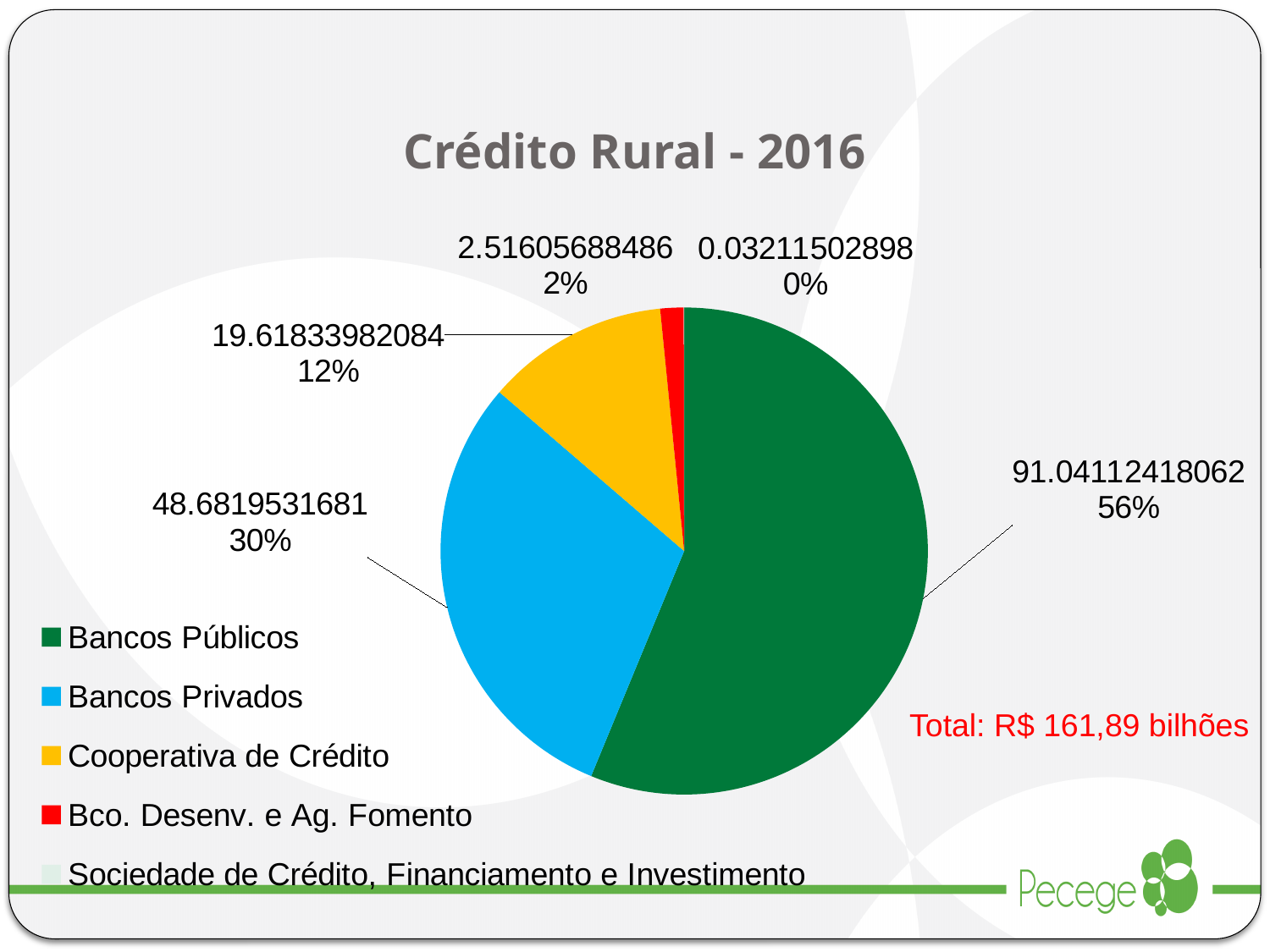
What share of the pie does Cooperativa de Crédito represent? 12% What value is shown for Bancos Privados? 48.6819531681 What value is shown for Bancos Públicos? 91.04112418062 What value is shown for Cooperativa de Crédito? 19.61833982084 How many categories does the legend of the pie chart list? 5 What kind of chart is shown on the slide? pie chart What value is shown for Bco. Desenv. e Ag. Fomento? 2.51605688486 What share of the pie does Bancos Públicos represent? 56% Which category has the smallest slice of the pie? Sociedade de Crédito, Financiamento e Investimento Which is larger, the share for Bancos Privados or the share for Cooperativa de Crédito? Bancos Privados Which category has the largest slice of the pie? Bancos Públicos What is the title of the chart? Crédito Rural - 2016